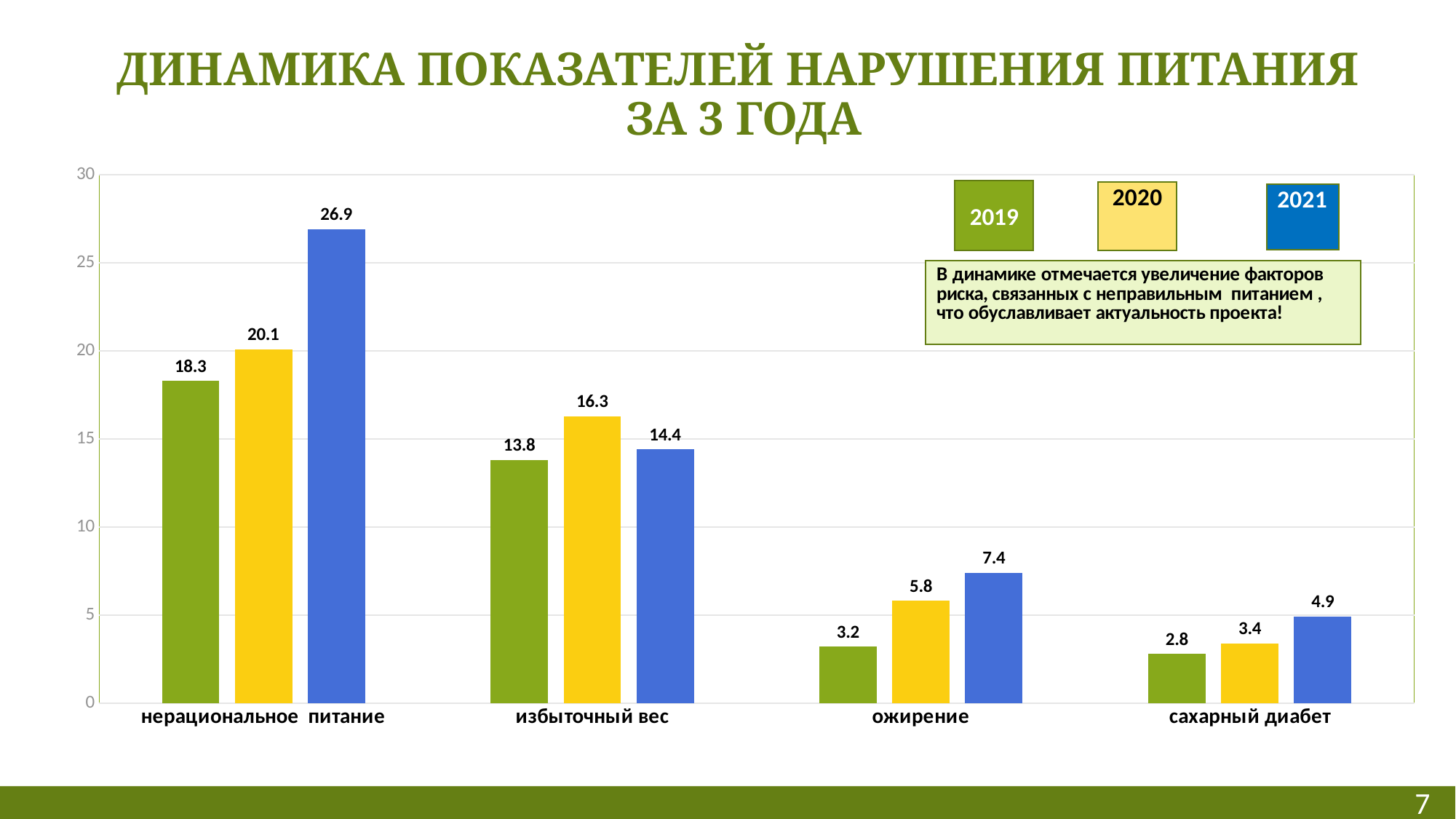
Which category has the lowest value in 2019? сахарный диабет How many categories are shown on the x axis? 4 Which category has the highest value in 2021? нерациональное питание What is the value for ожирение in 2019? 3.2 What is the difference between the 2021 and 2019 values for нерациональное питание? 8.6 What is the value for сахарный диабет in 2020? 3.4 What kind of chart is shown on the slide? bar chart How many series does the legend list? 3 What is the value for нерациональное питание in 2021? 26.9 Do the values for ожирение rise or fall from 2019 to 2021? rise Which year is shown in blue in the legend? 2021 Which is larger for избыточный вес: the 2020 value or the 2021 value? 2020